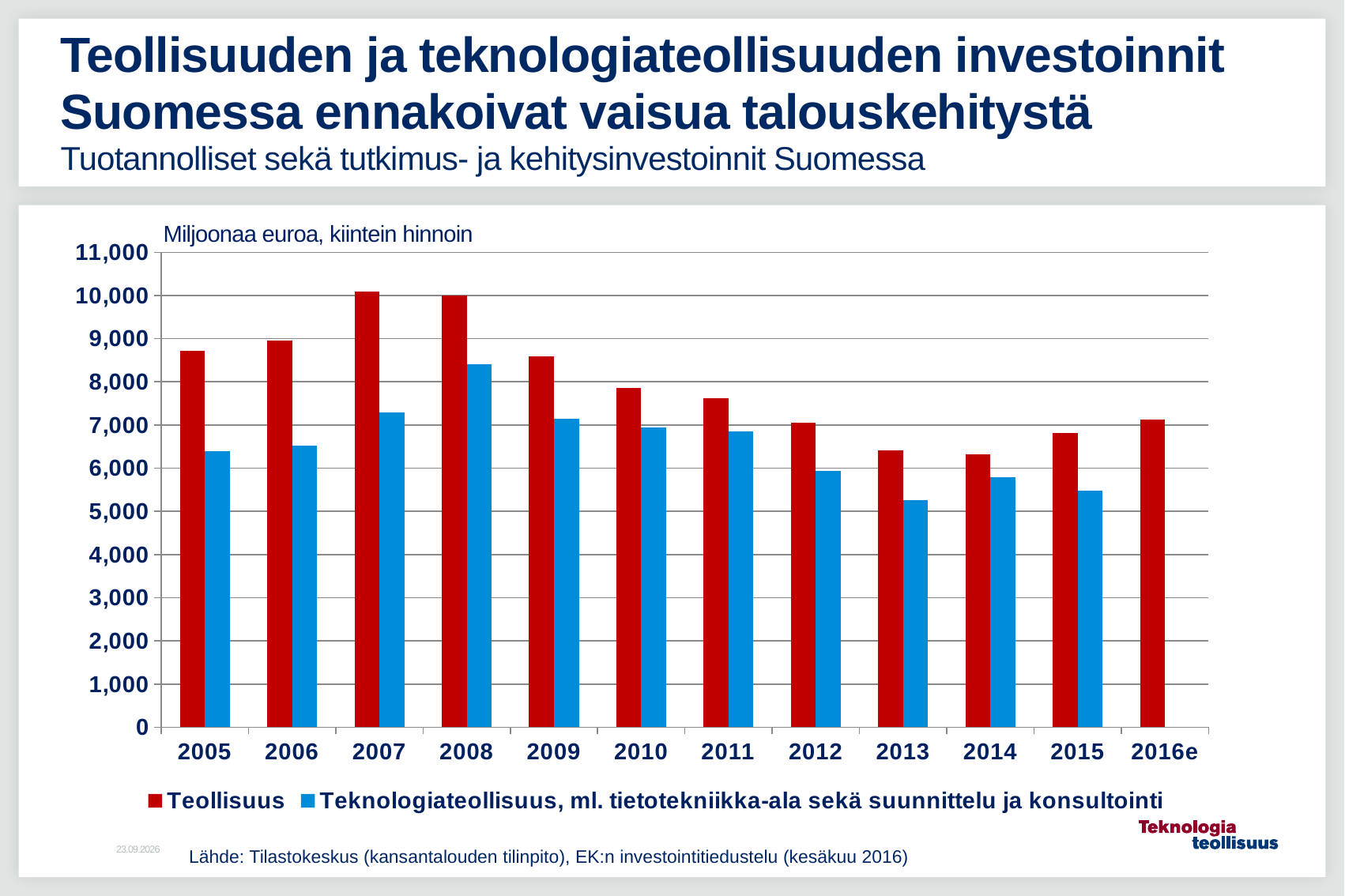
How many series does the legend list? 2 What kind of chart is shown on the slide? bar chart What unit is stated above the chart? Miljoonaa euroa, kiintein hinnoin Is the Teknologiateollisuus value for 2008 greater or less than 8,000? greater In 2005, which series has the larger value, Teollisuus or Teknologiateollisuus? Teollisuus Is the Teollisuus value for 2013 greater or less than 7,000? less How many years are shown on the x axis? 12 Is the Teollisuus value for 2007 greater or less than 9,000? greater In which year is the Teknologiateollisuus value highest? 2008 Do the Teollisuus values rise or fall from 2008 to 2014? fall In which year is the Teknologiateollisuus value lowest? 2013